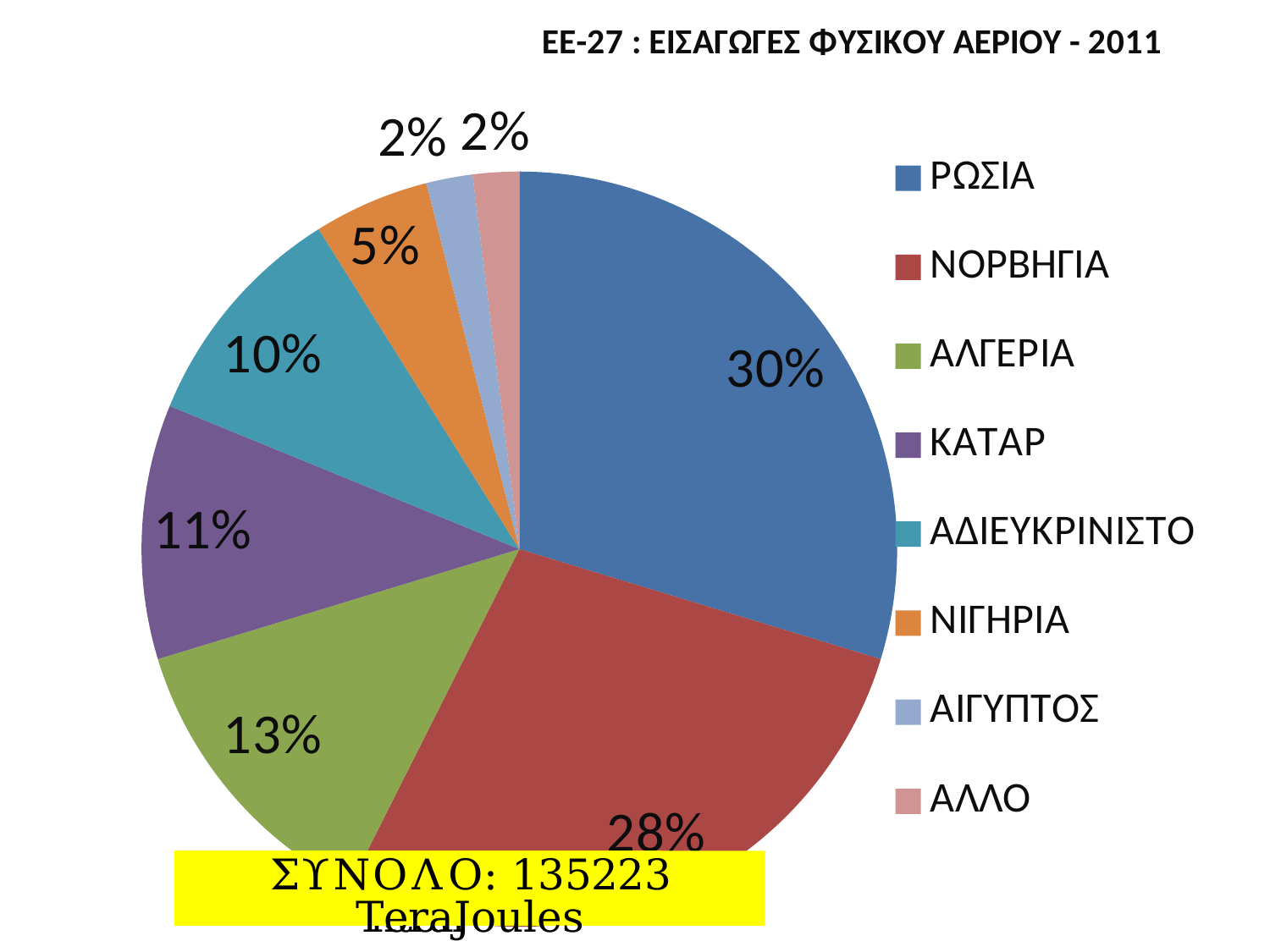
Which category has the largest slice of the pie? ΡΩΣΙΑ What is the difference in percentage points between ΡΩΣΙΑ and ΝΟΡΒΗΓΙΑ? 2 What is the value shown for ΑΛΓΕΡΙΑ? 13% What is the value shown for ΑΔΙΕΥΚΡΙΝΙΣΤΟ? 10% What is the value shown for ΝΙΓΗΡΙΑ? 5% How many categories does the legend list? 8 What is the value shown for ΚΑΤΑΡ? 11% What is the title of the chart? ΕΕ-27 : ΕΙΣΑΓΩΓΕΣ ΦΥΣΙΚΟΥ ΑΕΡΙΟΥ - 2011 What kind of chart is shown on the slide? pie chart What share of the pie does ΝΟΡΒΗΓΙΑ account for? 28% What share of the pie does ΡΩΣΙΑ account for? 30% Which is larger, the slice for ΑΛΓΕΡΙΑ or the slice for ΚΑΤΑΡ? ΑΛΓΕΡΙΑ